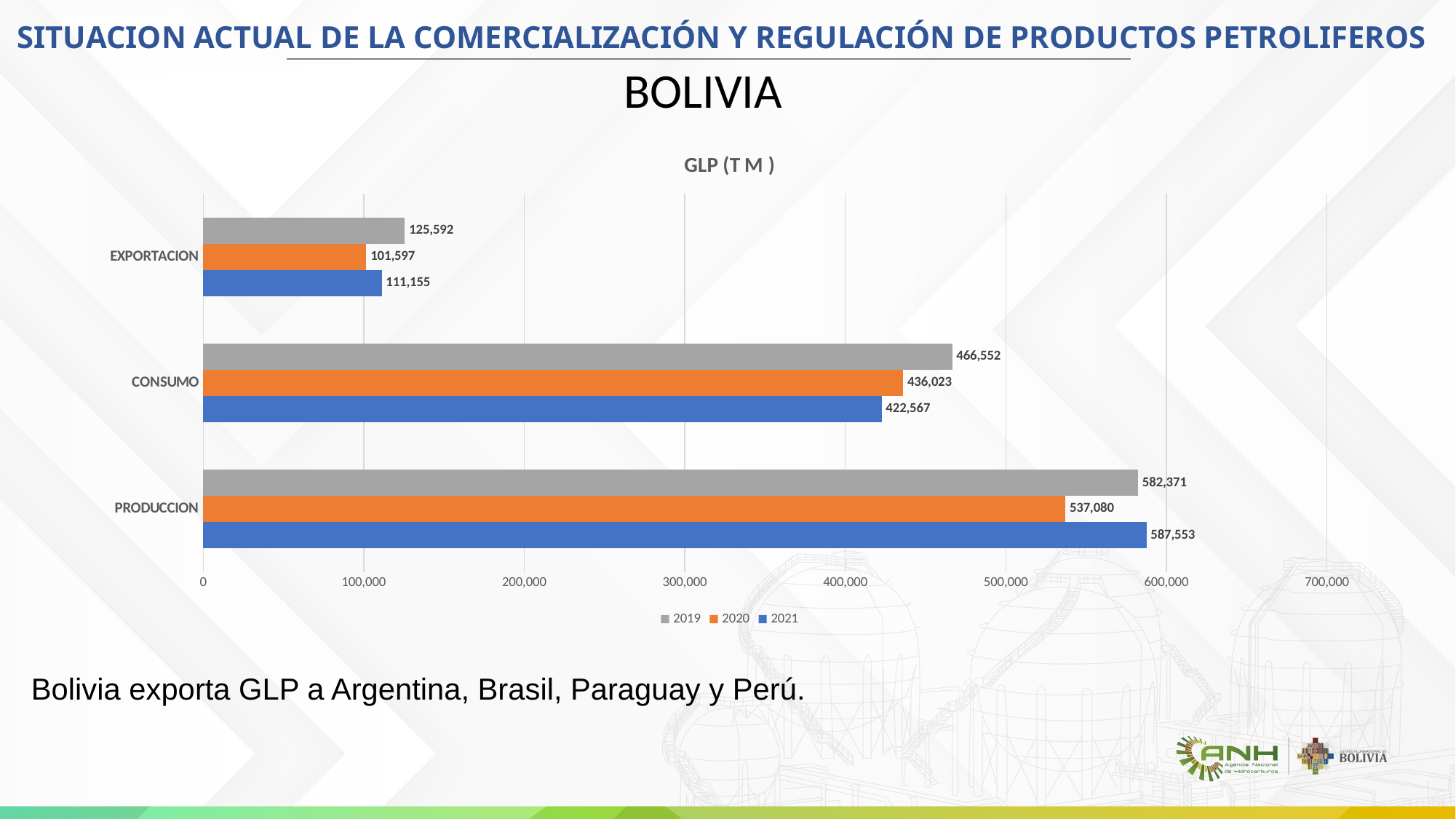
What is the difference between the 2019 and 2021 values for CONSUMO? 43,985 What is the title of the chart? GLP (T M ) What is the value for PRODUCCION in 2021? 587,553 Is the value for EXPORTACION in 2021 greater or less than 200,000? less How many series does the legend list? 3 What is the value for CONSUMO in 2019? 466,552 What type of chart is shown on the slide? Bar chart Which category has the lowest value in the 2021 series? EXPORTACION Which category has the highest value in the 2020 series? PRODUCCION For CONSUMO, which is larger: the 2020 value or the 2021 value? 2020 What is the value for EXPORTACION in 2020? 101,597 How many categories are shown on the chart? 3